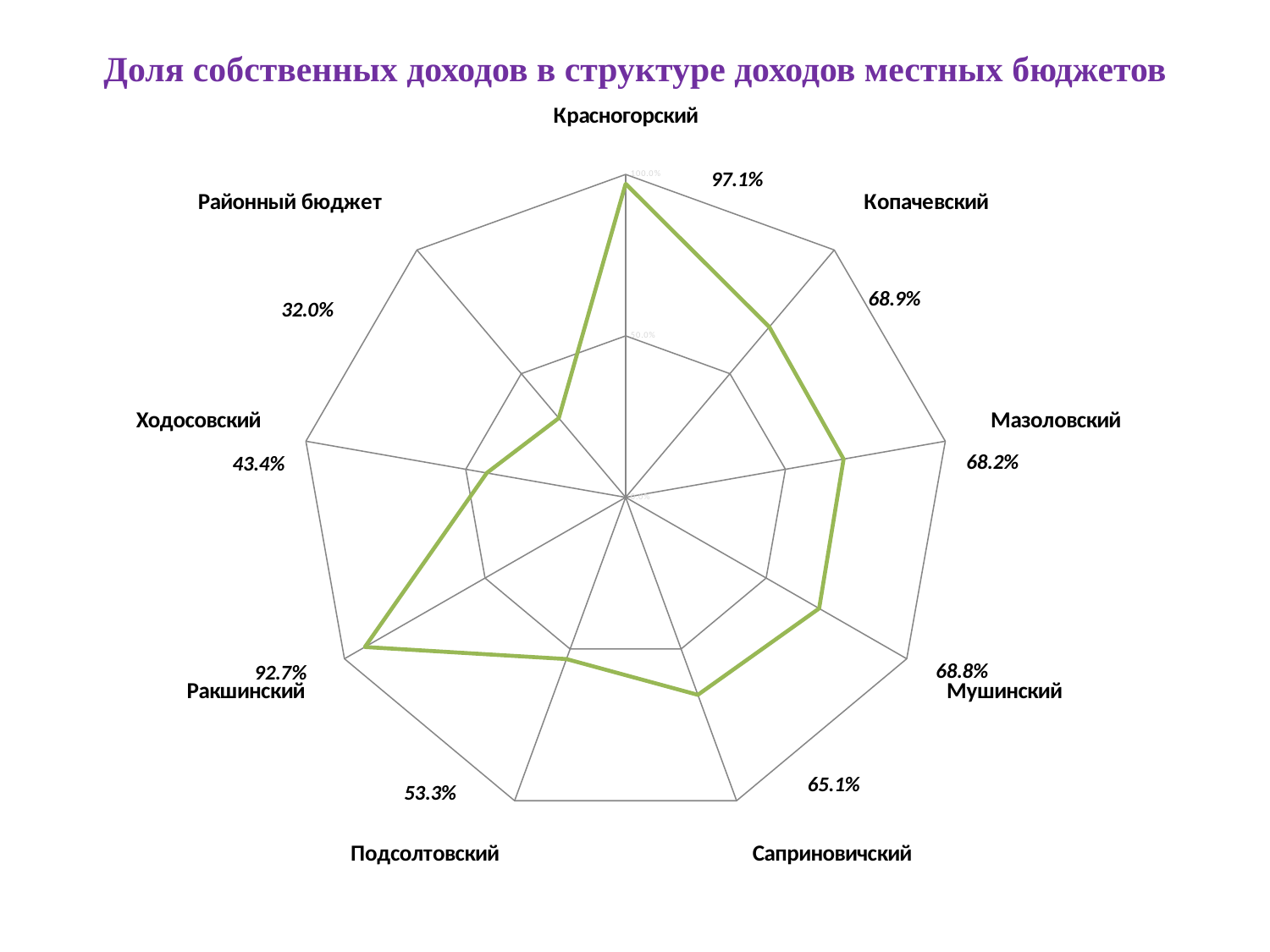
Which category has the highest value? Красногорский What is the value for Подсолтовский? 53.3% What is the value for Районный бюджет? 32.0% What is the value for Красногорский? 97.1% How many categories are shown on the chart? 9 What kind of chart is shown on the slide? radar chart What is the difference between the values for Красногорский and Ракшинский? 4.4% What is the difference between the values for Ходосовский and Районный бюджет? 11.4% Which is larger, the value for Ракшинский or the value for Подсолтовский? Ракшинский Which category has the lowest value? Районный бюджет Is the value for Ходосовский greater or less than 50.0%? less What is the value for Ракшинский? 92.7%